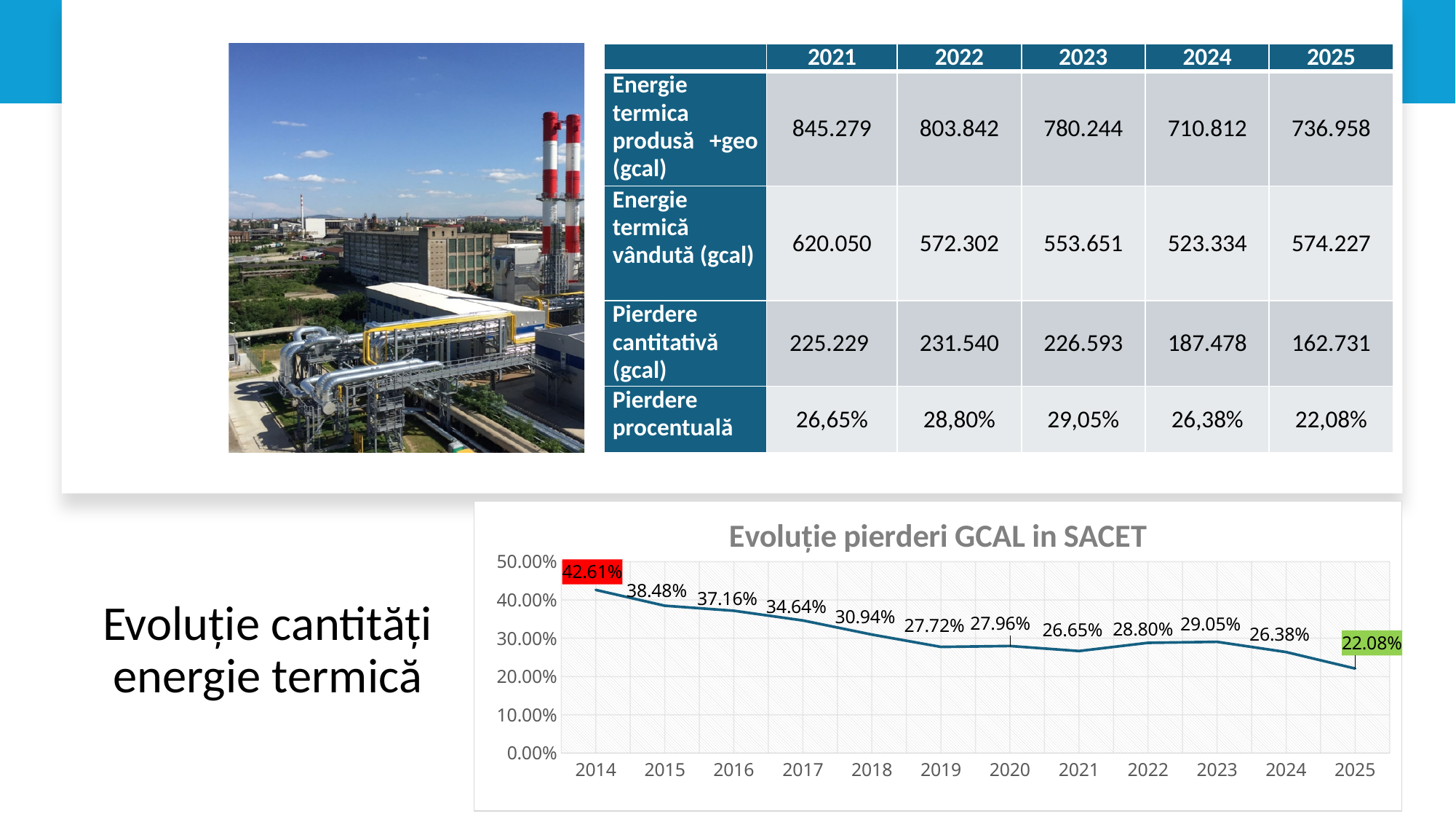
What is the difference between the values for 2022 and 2021? 2.15% Which year has the larger value, 2019 or 2020? 2020 How many years are plotted on the x axis of the chart? 12 What is the value for 2014 in the chart? 42.61% Which year has the highest value in the chart? 2014 What type of chart is shown on the slide? line chart What is the title of the chart? Evoluție pierderi GCAL in SACET What is the difference between the values for 2014 and 2025? 20.53% What is the value for 2025 in the chart? 22.08% Do the values generally rise or fall from 2014 to 2025? fall What is the value for 2018 in the chart? 30.94% Which year has the lowest value in the chart? 2025